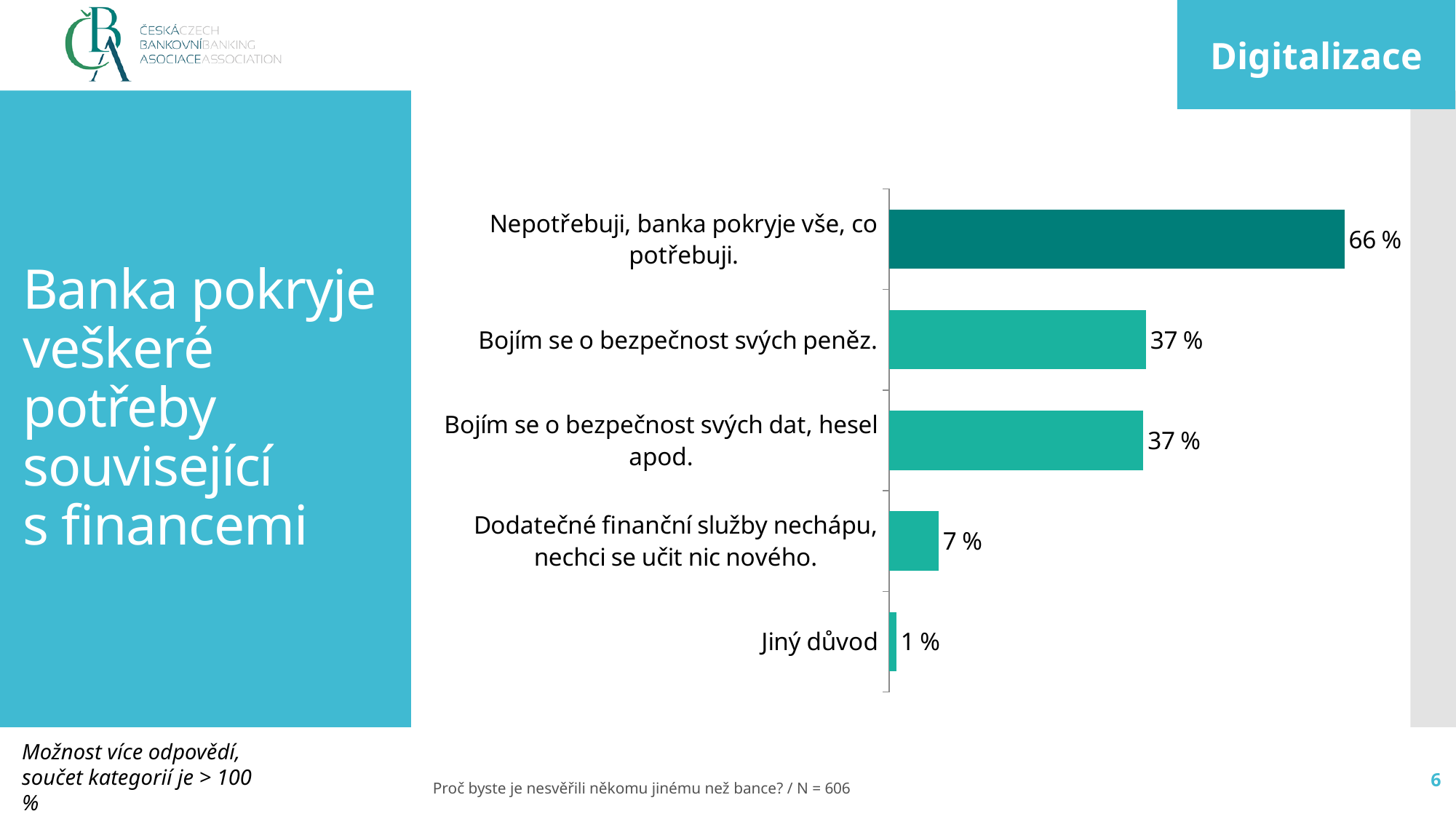
What is the value for "Nepotřebuji, banka pokryje vše, co potřebuji."? 66 % What is the value for "Dodatečné finanční služby nechápu, nechci se učit nic nového."? 7 % Which category has the lowest value? Jiný důvod Which is larger: the value for "Bojím se o bezpečnost svých dat, hesel apod." or for "Dodatečné finanční služby nechápu, nechci se učit nic nového."? Bojím se o bezpečnost svých dat, hesel apod. What is the difference between the values for "Nepotřebuji, banka pokryje vše, co potřebuji." and "Bojím se o bezpečnost svých peněz."? 29 % What is the survey question and sample size noted below the chart? Proč byste je nesvěřili někomu jinému než bance? / N = 606 What kind of chart is shown on the slide? Bar chart What is the value for "Bojím se o bezpečnost svých peněz."? 37 % Which category has the highest value? Nepotřebuji, banka pokryje vše, co potřebuji. What is the difference between the values for "Dodatečné finanční služby nechápu, nechci se učit nic nového." and "Jiný důvod"? 6 % How many categories are shown in the chart? 5 What is the value for "Jiný důvod"? 1 %